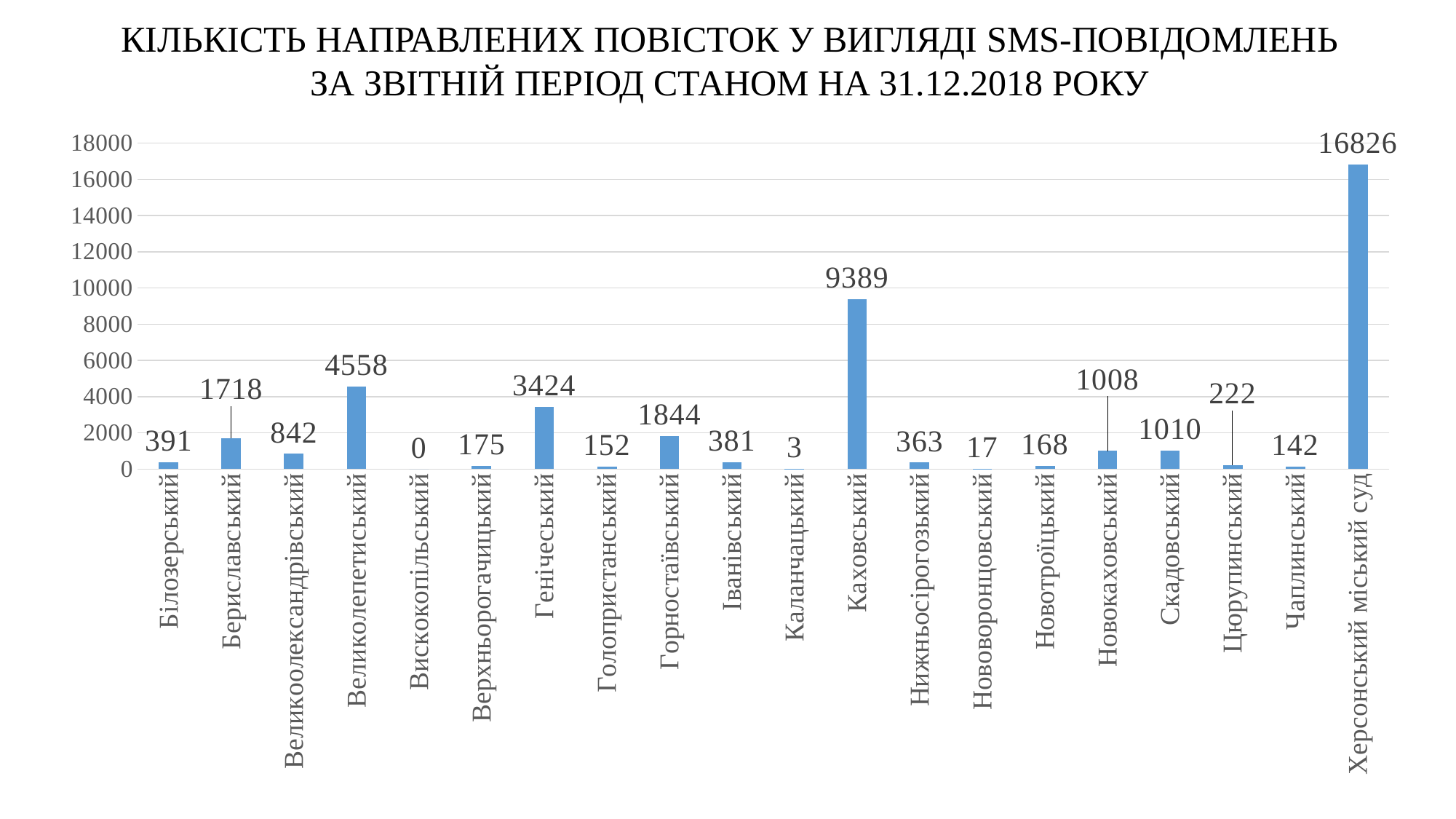
Which category has the lowest value? Вискокопільський What kind of chart is shown on the slide? bar chart What is the difference between the values for Херсонський міський суд and Каховський? 7437 What is the difference between the values for Горностаївський and Бериславський? 126 Which category has the highest value? Херсонський міський суд What is the value for Каховський? 9389 What is the value for Нововоронцовський? 17 What is the value for Великолепетиський? 4558 Is the value for Каховський greater or less than 8000? greater How many categories are shown on the x axis? 20 What is the value for Генічеський? 3424 Which is larger, the value for Великолепетиський or the value for Генічеський? Великолепетиський